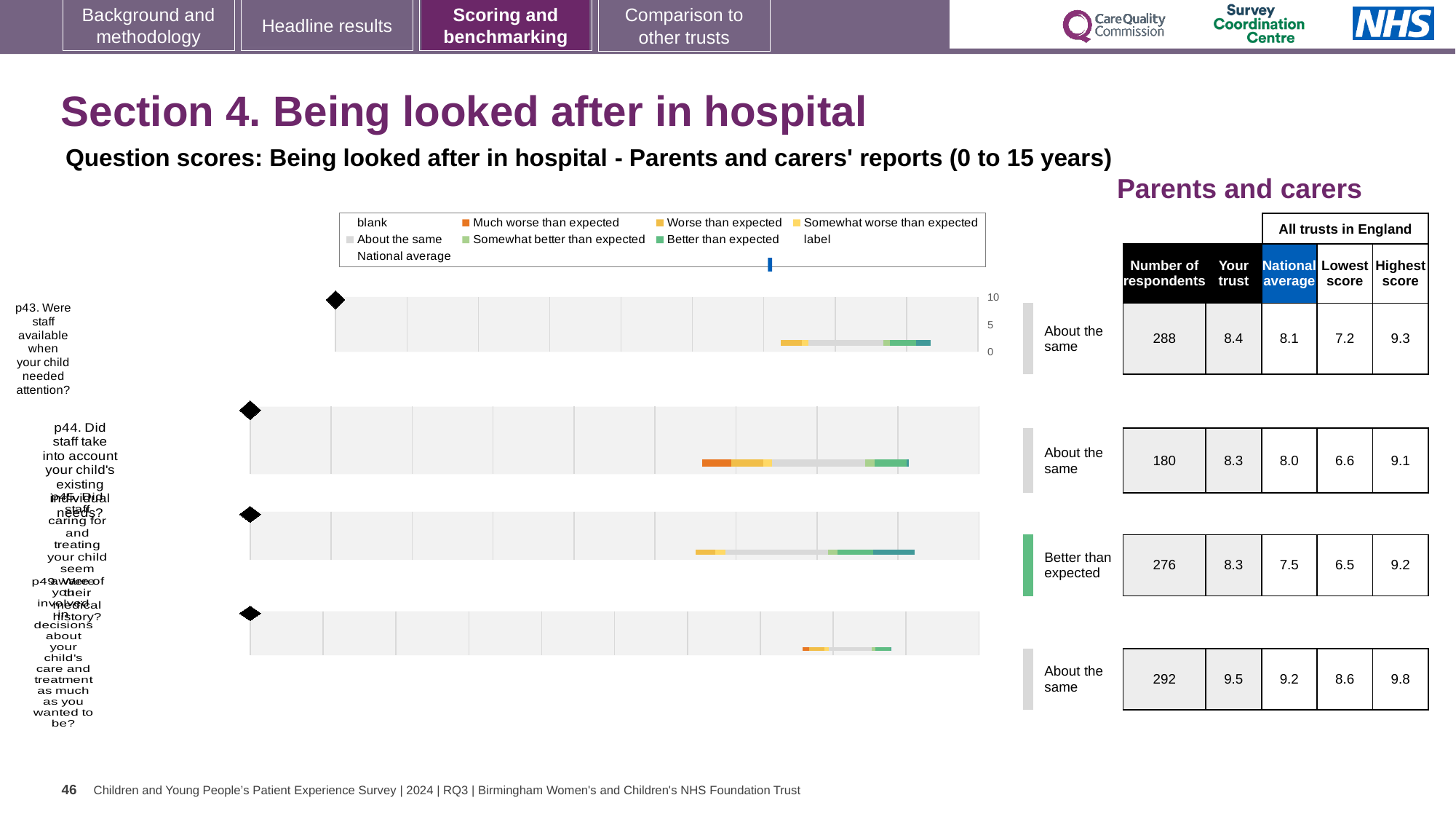
Which of the four charts is rated 'Better than expected' rather than 'About the same'? The third chart For the second chart (p44, Did staff take into account your child's existing individual needs?), what is the lowest score among all trusts in England? 6.6 For the second chart (p44), what is the highest score among all trusts in England? 9.1 For the second chart (p44), which is larger: the 'Your trust' score or the national average? Your trust For the first chart (p43), what is the difference between the 'Your trust' score and the national average? 0.3 For the fourth (bottom) chart, what is the highest score among all trusts in England? 9.8 How many question charts are shown on the slide? 4 For the first chart (p43), what is the national average score? 8.1 For the third chart, how many respondents are listed? 276 Across the four charts on the slide, which one has the highest 'Your trust' score? The fourth (bottom) chart, p49, with 9.5 For the first chart (p43), how many respondents are listed? 288 For the first chart (p43, Were staff available when your child needed attention?), what is the 'Your trust' score shown in the table? 8.4